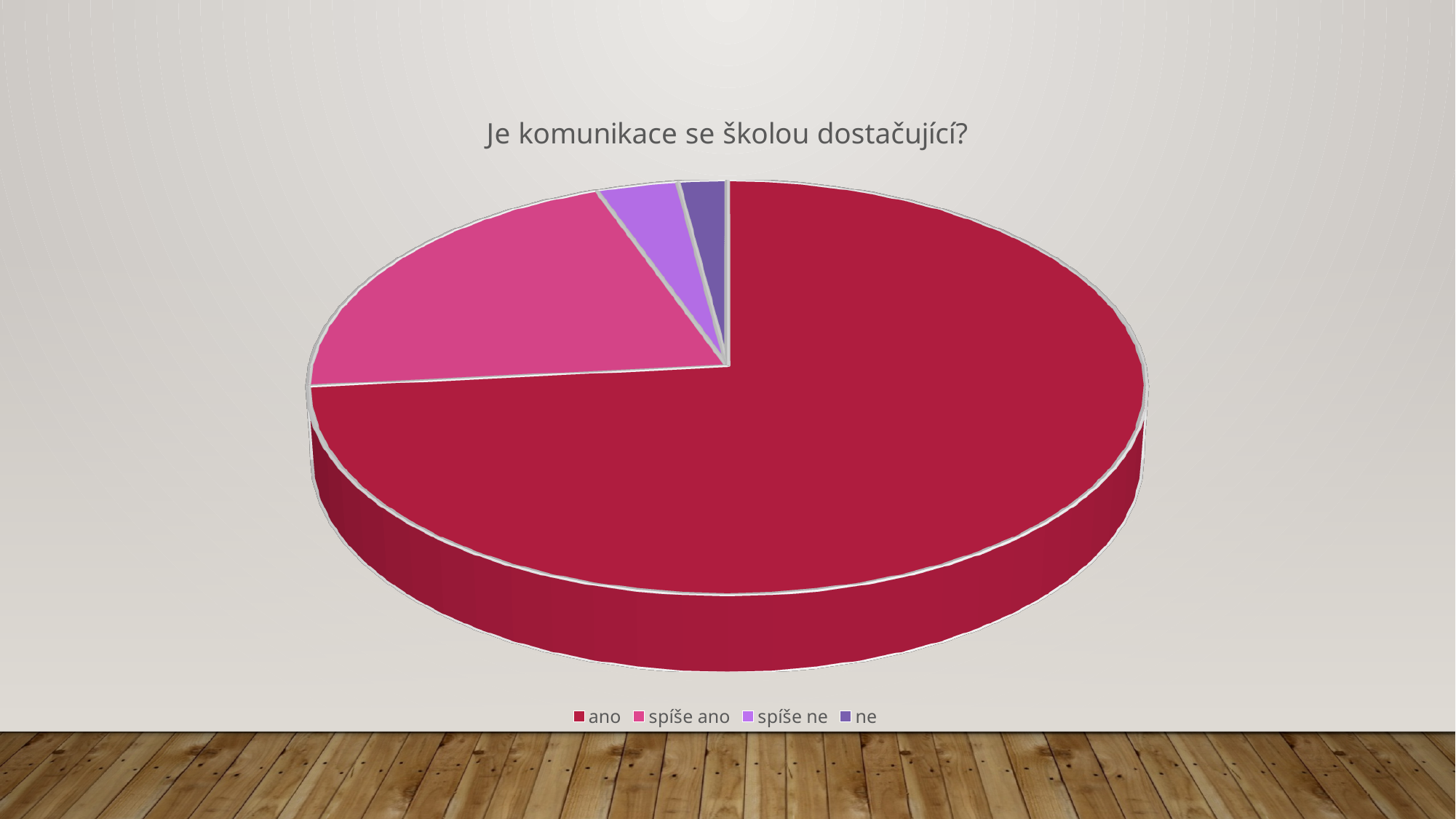
Which category has the smallest slice of the pie? ne How many categories does the legend of the chart list? 4 Which category is shown in the second-largest slice of the pie? spíše ano What kind of chart is shown on the slide? pie chart Which slice is larger, "ano" or "spíše ano"? ano Which slice is larger, "spíše ano" or "spíše ne"? spíše ano Which category has the largest slice of the pie? ano How many slices does the pie chart have? 4 What is the title of the chart? Je komunikace se školou dostačující? What are the legend entries of the chart, in order? ano, spíše ano, spíše ne, ne